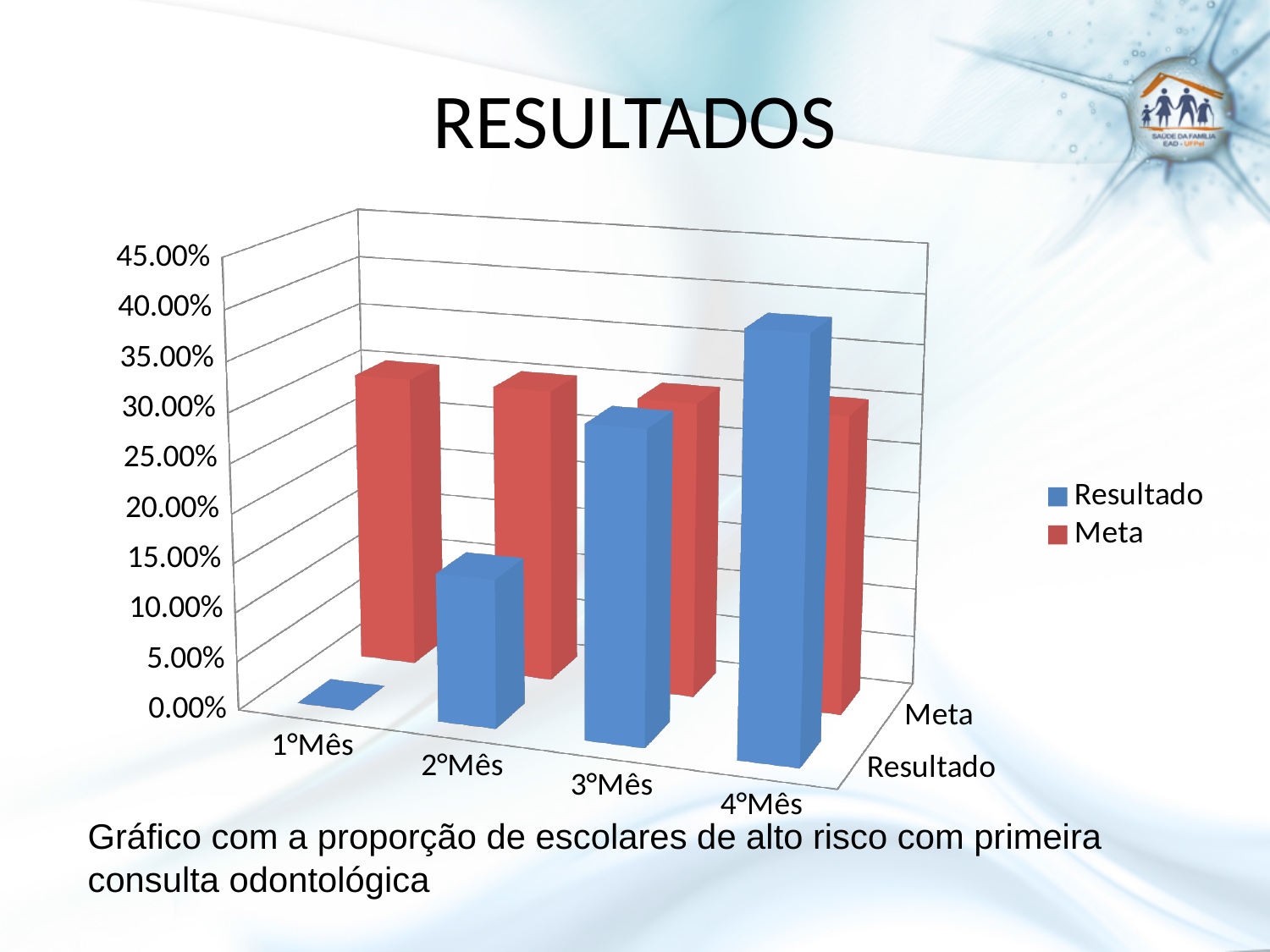
What kind of chart is shown on the slide? bar chart Do the Resultado values rise or fall from 1°Mês to 4°Mês? rise Is the Resultado value for 2°Mês greater or less than 25.00%? less How many series does the legend list? 2 For 4°Mês, which is larger: Resultado or Meta? Resultado Which month has the lowest Resultado value? 1°Mês Is the Resultado value for 4°Mês greater or less than 30.00%? greater Which colour represents the Meta series in the legend? red For 1°Mês, which is larger: Resultado or Meta? Meta Is the Resultado value for 1°Mês greater or less than 5.00%? less Which month has the highest Resultado value? 4°Mês How many month categories are shown on the x axis? 4